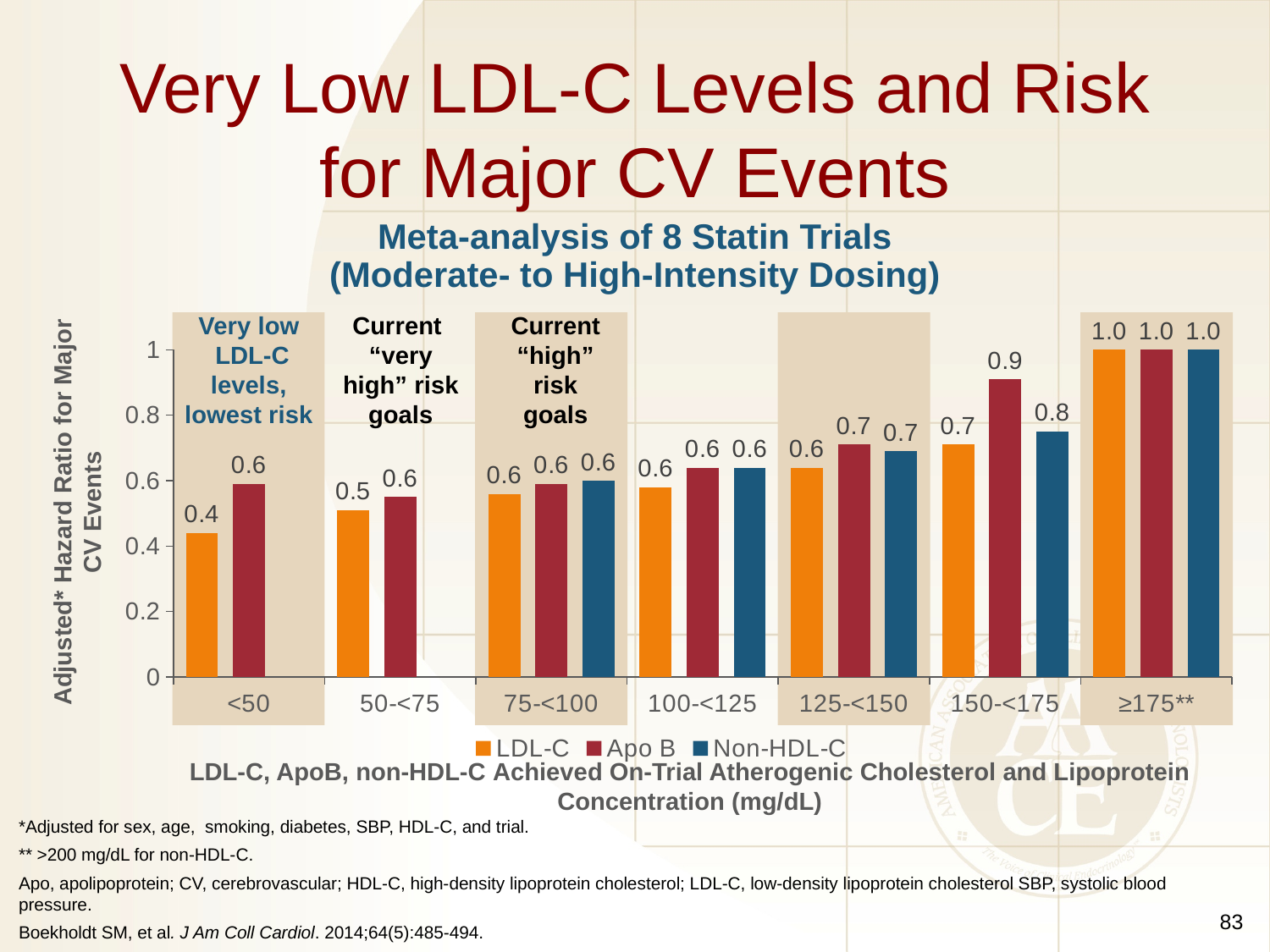
Which concentration category has the lowest LDL-C hazard ratio? <50 How many series does the legend list? 3 Do the LDL-C hazard ratios rise or fall as concentration increases along the x axis? Rise What is the adjusted hazard ratio for Non-HDL-C in the 150-<175 mg/dL category? 0.8 In the 150-<175 mg/dL category, which is larger: the Apo B hazard ratio or the LDL-C hazard ratio? Apo B What is the adjusted hazard ratio for LDL-C in the 50-<75 mg/dL category? 0.5 What is the adjusted hazard ratio for LDL-C in the <50 mg/dL category? 0.4 What is the adjusted hazard ratio for Apo B in the 150-<175 mg/dL category? 0.9 What is the difference between the Apo B and LDL-C hazard ratios in the <50 mg/dL category? 0.2 What kind of chart is shown on the slide? Bar chart How many concentration categories are shown on the x axis? 7 Which concentration category has the highest Apo B hazard ratio? ≥175**